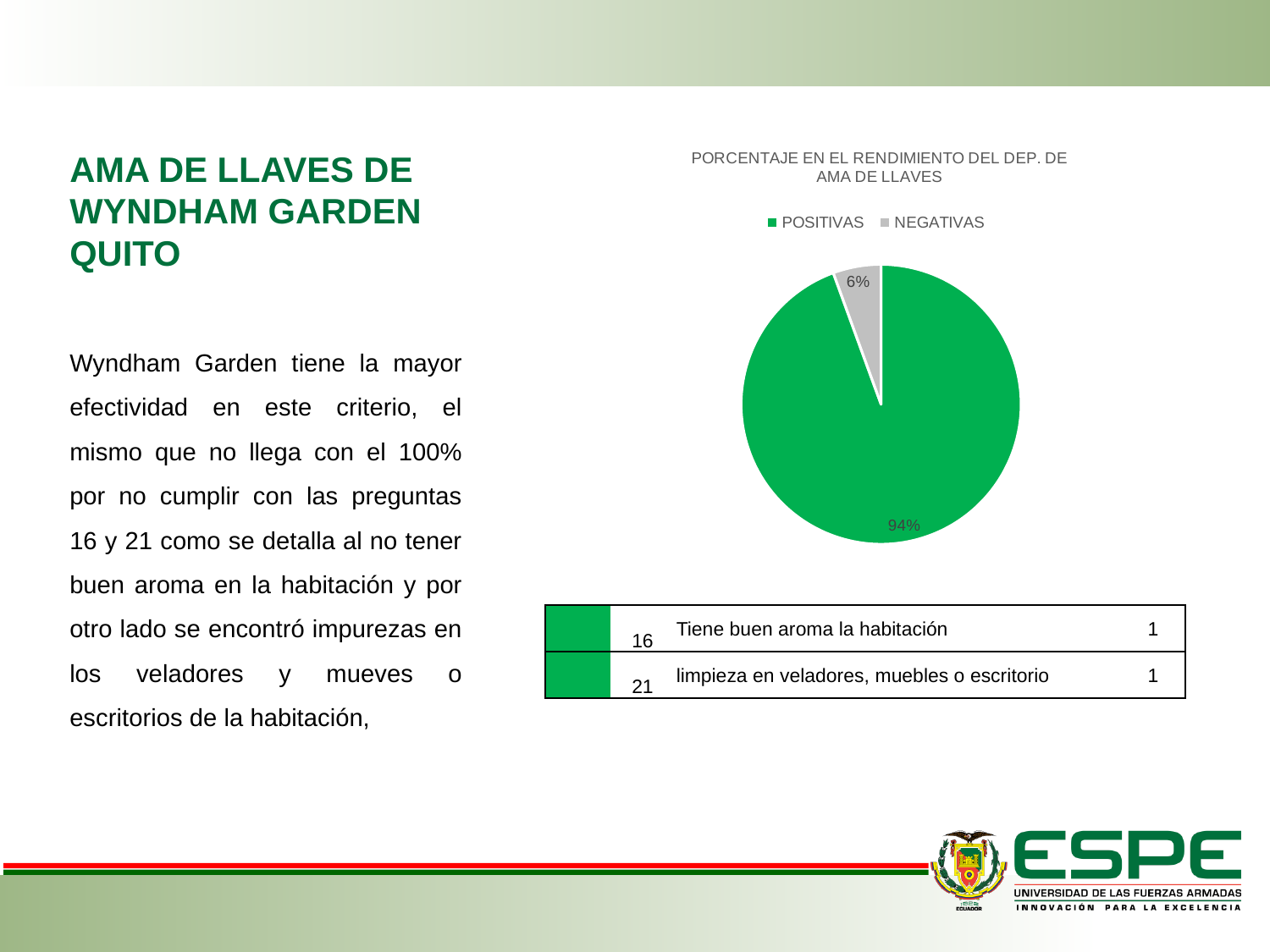
What kind of chart is shown on the slide? pie chart What percentage does the NEGATIVAS slice show? 6% Which slice is the largest in the pie chart? POSITIVAS What percentage does the POSITIVAS slice show? 94% What colour is the POSITIVAS slice? green Which is larger, the POSITIVAS slice or the NEGATIVAS slice? POSITIVAS How many entries does the legend list? 2 Which slice is the smallest in the pie chart? NEGATIVAS What is the difference in percentage points between the POSITIVAS and NEGATIVAS slices? 88 How many slices does the pie chart have? 2 What is the title of the chart? PORCENTAJE EN EL RENDIMIENTO DEL DEP. DE AMA DE LLAVES